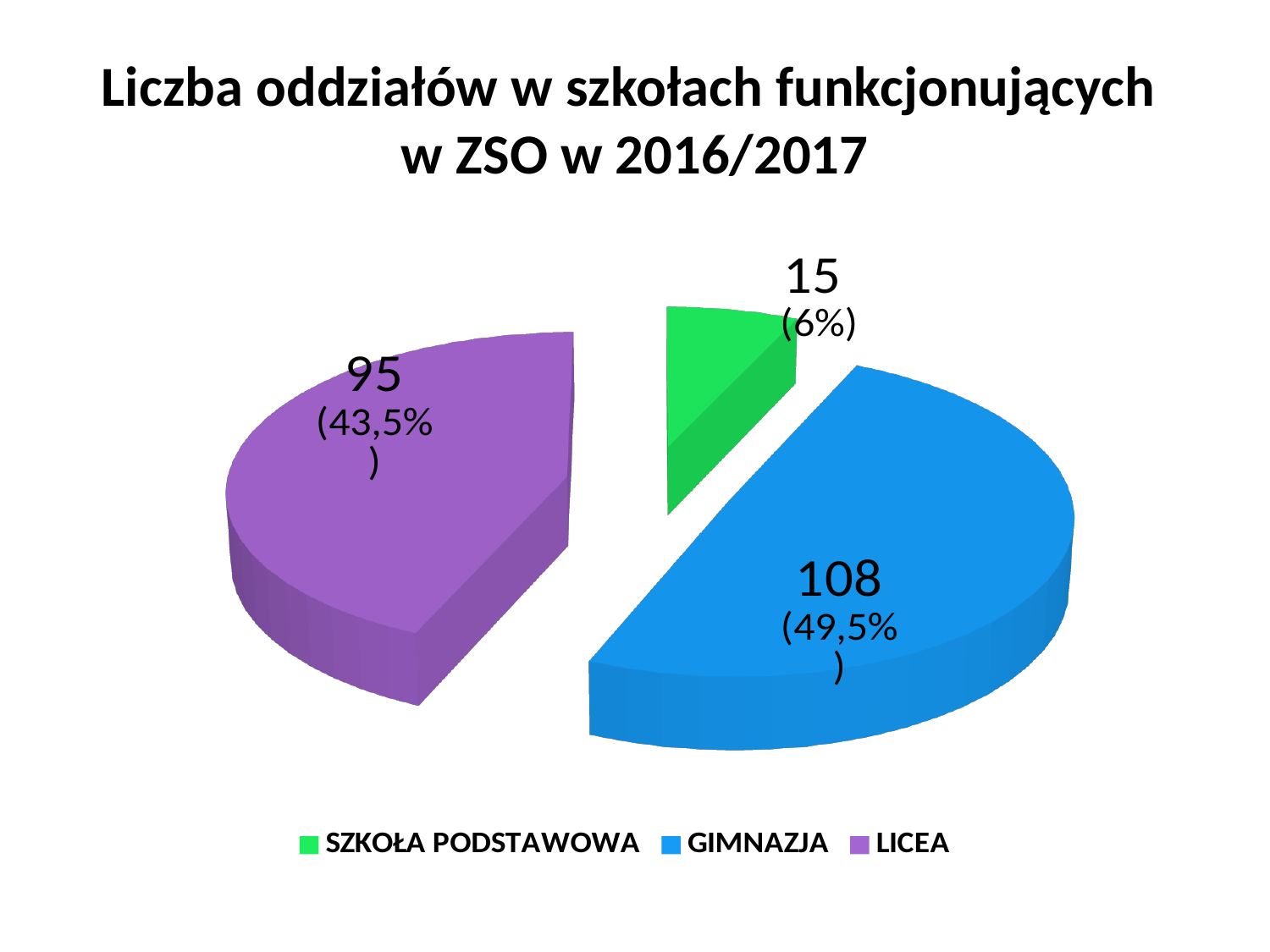
Which category has the smallest slice? SZKOŁA PODSTAWOWA What kind of chart is shown on the slide? pie chart Which category has the largest slice? GIMNAZJA What is the value for GIMNAZJA? 108 How many slices does the pie chart have? 3 What share of the pie does SZKOŁA PODSTAWOWA represent? 6% What is the difference between the values for GIMNAZJA and LICEA? 13 What is the value for SZKOŁA PODSTAWOWA? 15 What share of the pie does LICEA represent? 43,5% What is the value for LICEA? 95 What colour is the GIMNAZJA slice? blue Which is larger, the value for LICEA or the value for SZKOŁA PODSTAWOWA? LICEA